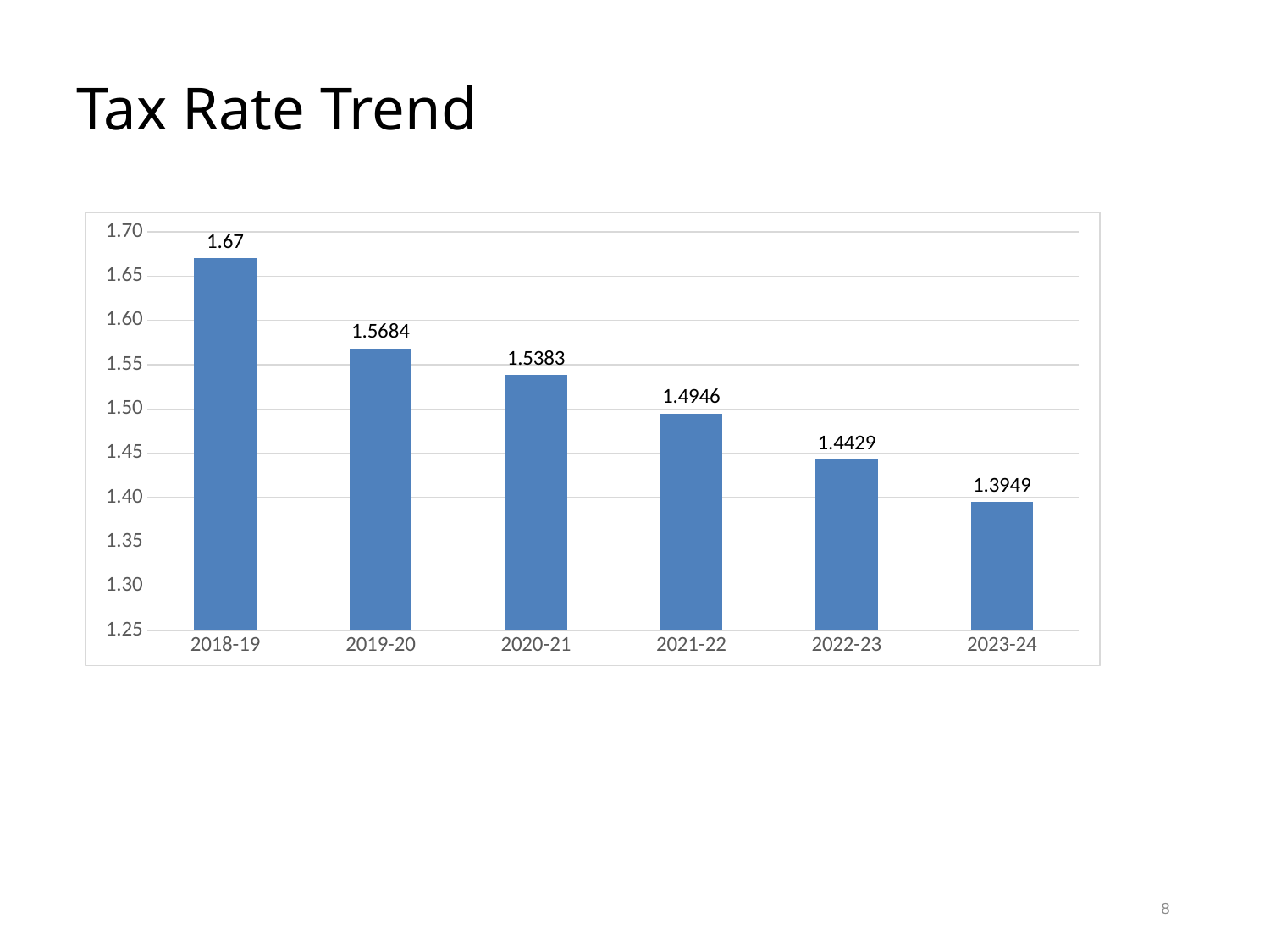
What is the difference between the tax rate in 2019-20 and in 2020-21? 0.0301 What kind of chart is shown on the slide? Bar chart Do the tax rates rise or fall from 2018-19 to 2023-24? Fall What is the tax rate for 2018-19? 1.67 Which year has the lowest tax rate? 2023-24 What is the tax rate for 2023-24? 1.3949 Is the value for 2022-23 greater or less than 1.40? greater What is the difference between the tax rate in 2018-19 and in 2023-24? 0.2751 What is the tax rate for 2021-22? 1.4946 Which year has the highest tax rate? 2018-19 Which is larger, the tax rate for 2020-21 or for 2022-23? 2020-21 How many years are shown on the chart? 6